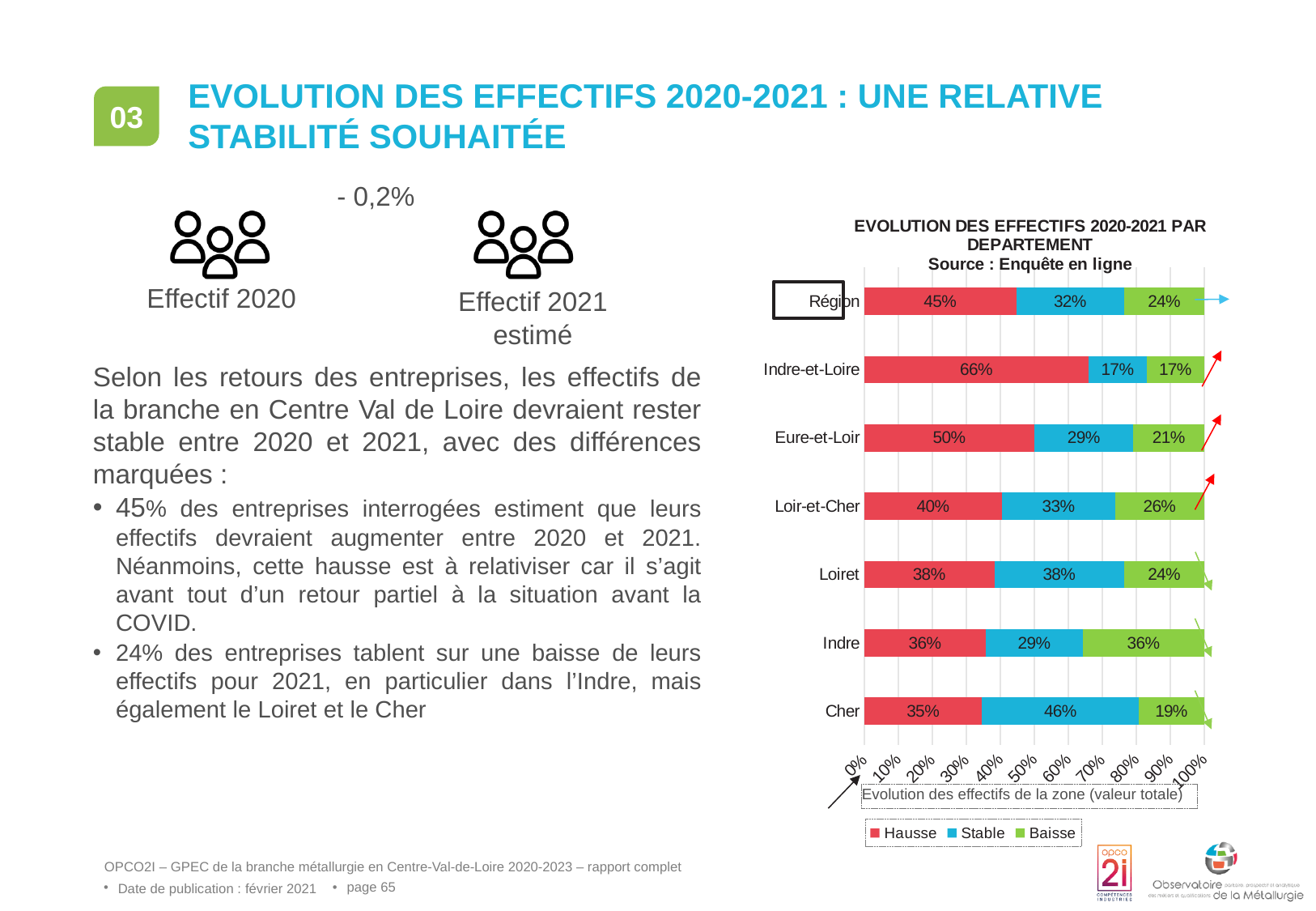
Which series is shown in red in the chart? Hausse What is the source stated in the chart title? Enquête en ligne What is the Baisse value for Indre? 36% How many categories (departments/region) are shown on the chart? 7 What type of chart is shown on the slide? Stacked bar chart Which category has the highest Hausse value? Indre-et-Loire What is the Hausse value for Indre-et-Loire? 66% How many series does the chart legend list? 3 Which category has the lowest Stable value? Indre-et-Loire What is the difference between the Hausse value for Région and the Hausse value for Cher? 10% Which is larger: the Baisse value for Loir-et-Cher or the Baisse value for Eure-et-Loir? Loir-et-Cher What is the Stable value for Cher? 46%